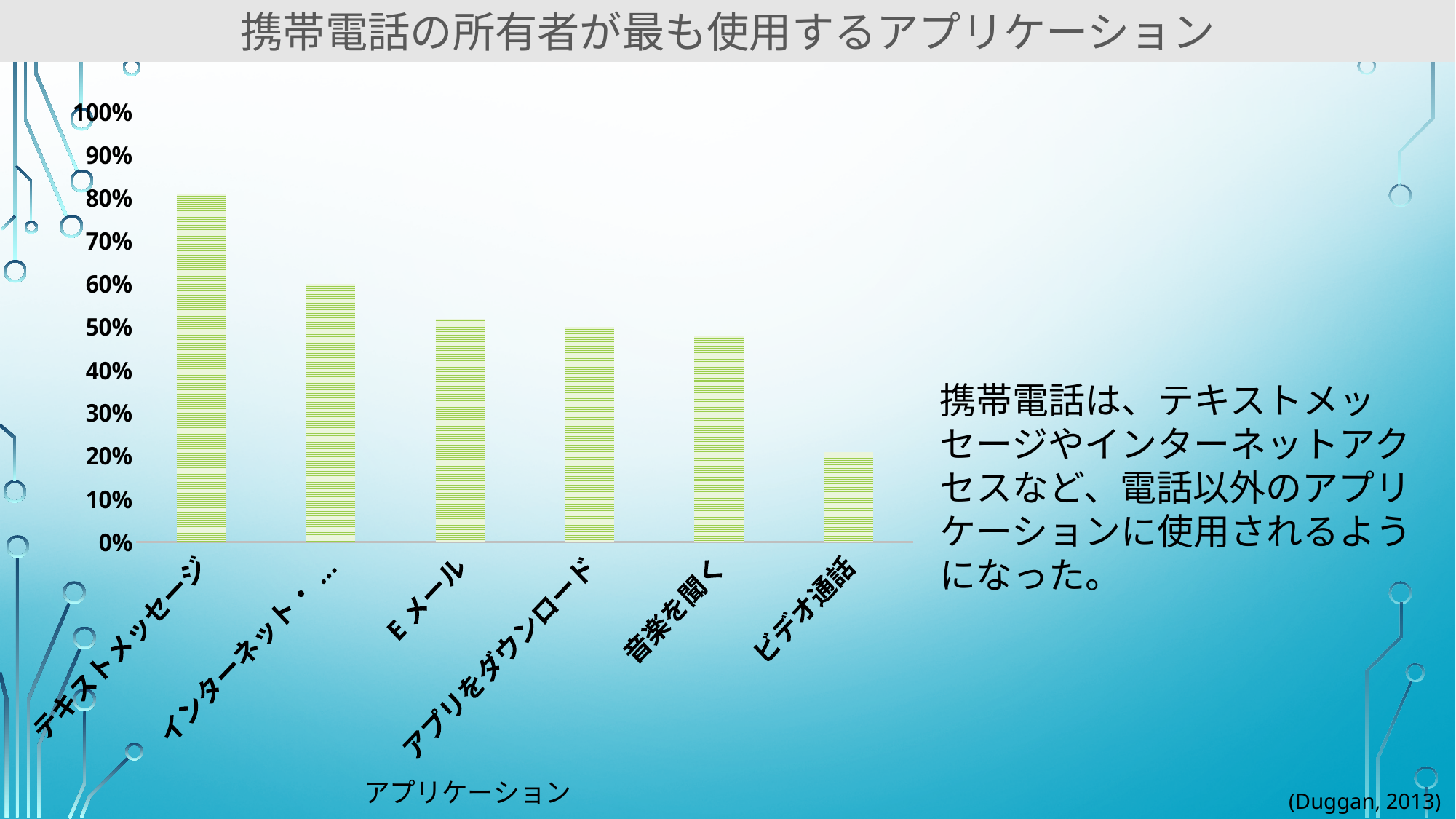
Which is larger, the value for テキストメッセージ or the value for 音楽を聞く? テキストメッセージ Which application has the lowest value on the chart? ビデオ通話 Is the value for 音楽を聞く greater or less than 40%? greater Which is larger, the value for Eメール or the value for ビデオ通話? Eメール What kind of chart is shown on the slide? bar chart Which application has the highest value on the chart? テキストメッセージ What is the title of the x axis of the chart? アプリケーション Is the value for テキストメッセージ greater or less than 70%? greater Do the bar values rise or fall from left to right along the x axis? fall Is the value for ビデオ通話 greater or less than 30%? less How many application categories are plotted on the chart? 6